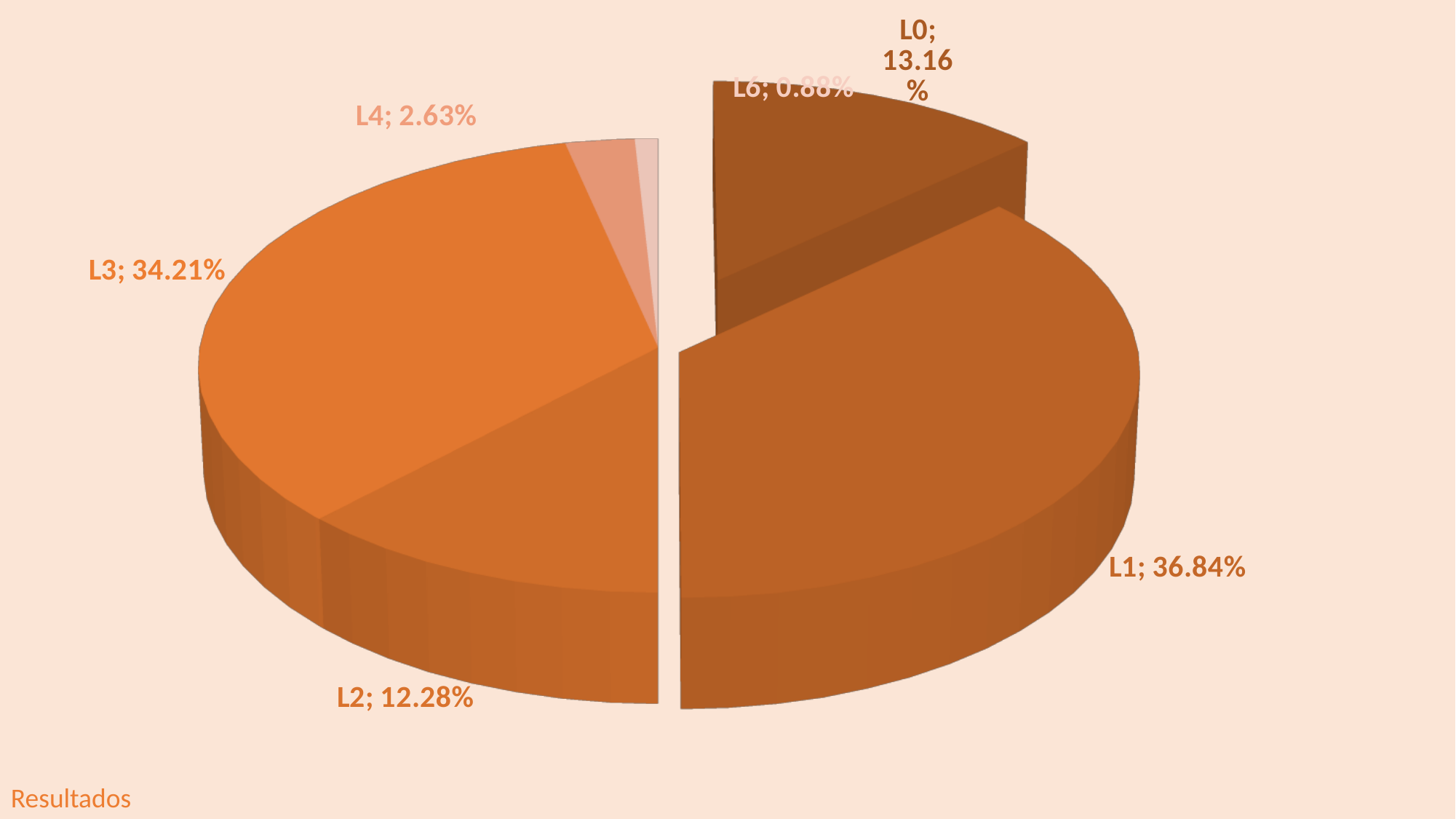
What kind of chart is shown on the slide? pie chart What is the value shown for L2? 12.28% What is the difference between the shares of L1 and L3? 2.63% Which slice has the smallest share of the pie? L6 Which slice has the largest share of the pie? L1 What is the value shown for L0? 13.16% What share of the pie does L1 have? 36.84% Which has a larger share, L0 or L2? L0 What share of the pie does L3 have? 34.21% What text appears in the bottom-left corner of the slide as the chart's title? Resultados How many slices are labelled in the pie chart? 6 What is the value shown for L4? 2.63%